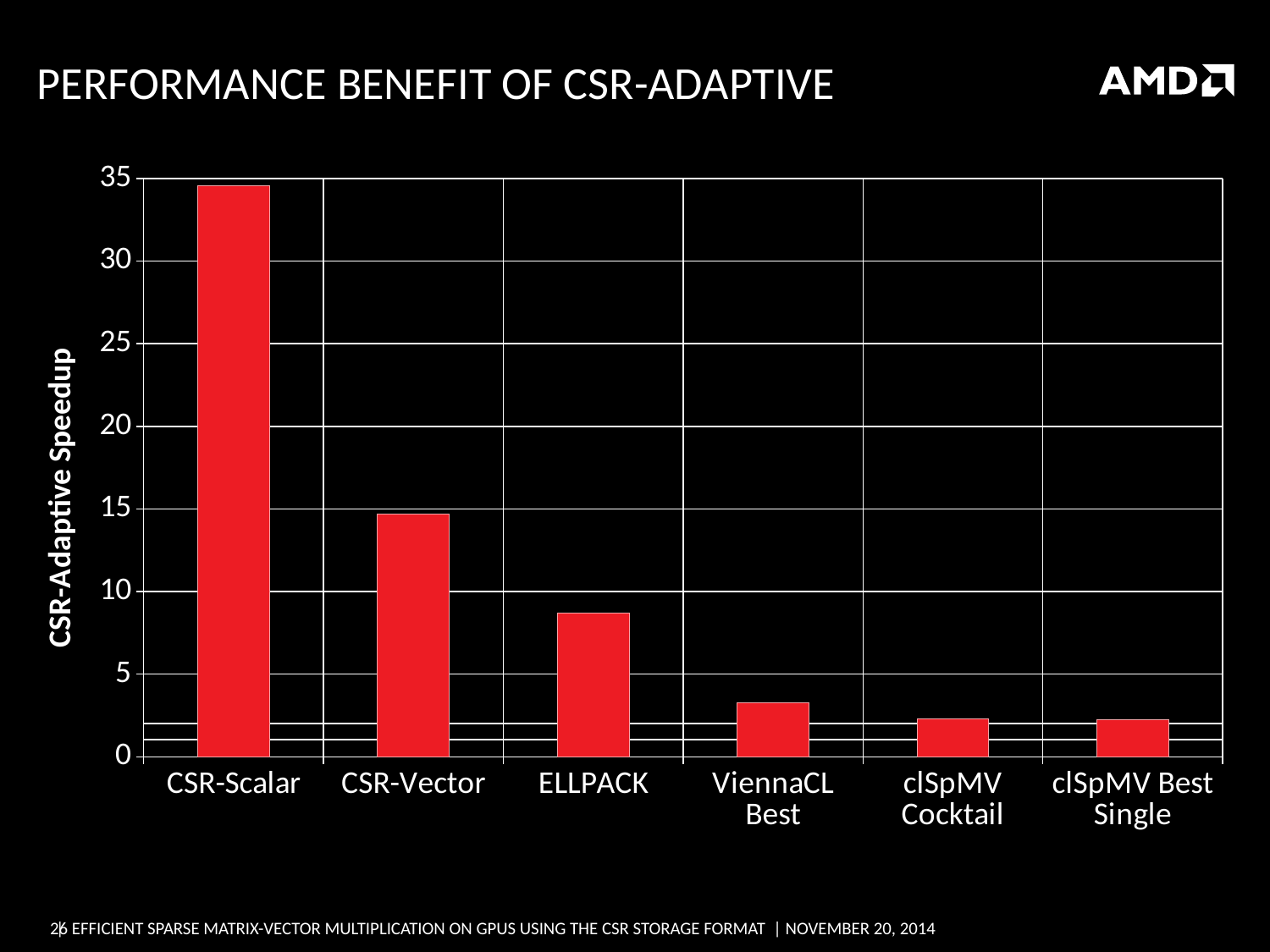
Is the value for ELLPACK greater or less than 10? less Which is larger, the value for ELLPACK or the value for ViennaCL Best? ELLPACK Which is larger, the value for CSR-Vector or the value for ELLPACK? CSR-Vector Is the value for CSR-Vector greater or less than 15? less Which category has the highest CSR-Adaptive Speedup? CSR-Scalar Do the values generally rise or fall moving from left to right along the x axis? fall Is the value for ViennaCL Best greater or less than 5? less What is the label of the y axis? CSR-Adaptive Speedup How many categories are plotted on the x axis? 6 What kind of chart is shown on the slide? bar chart